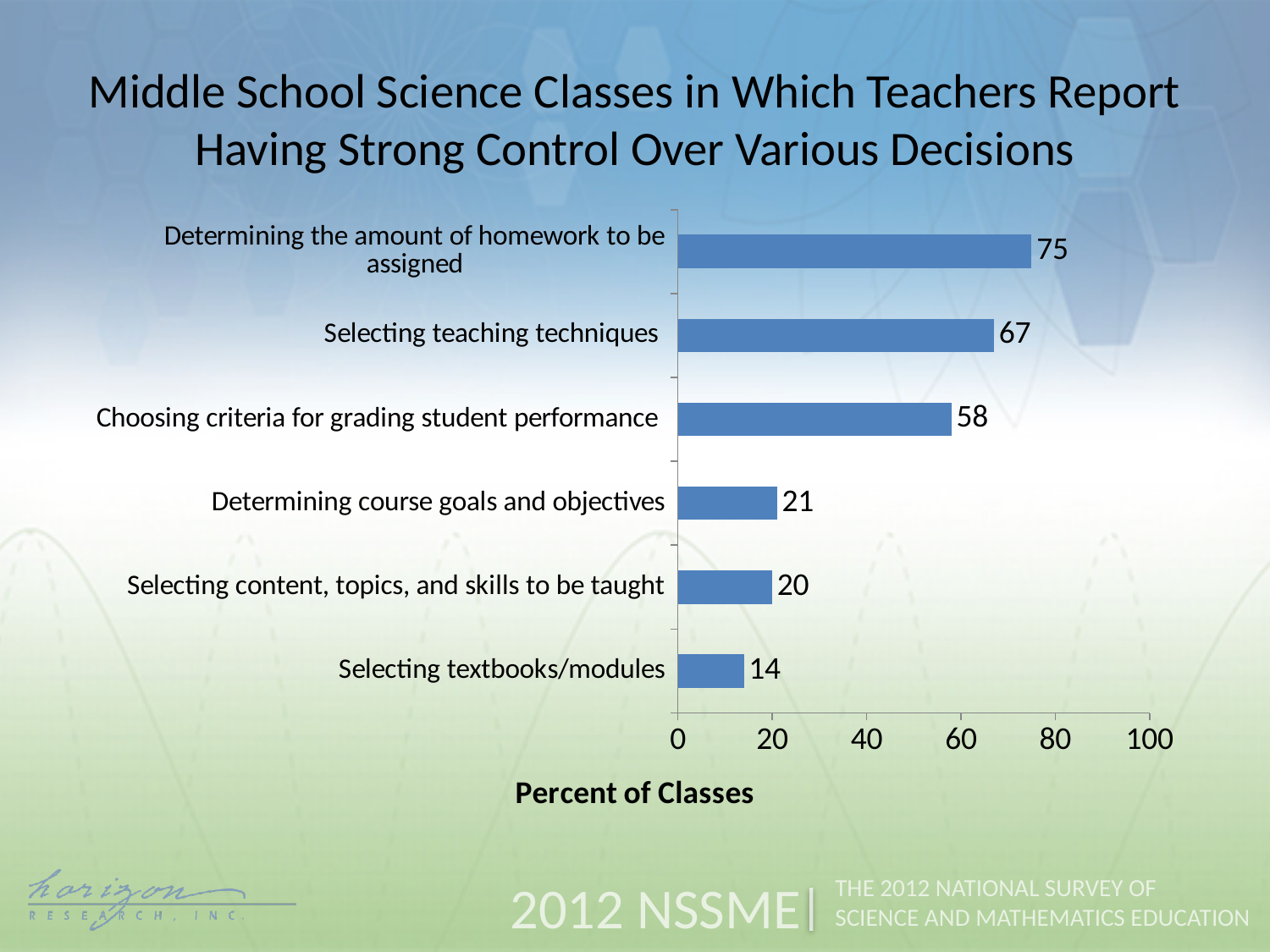
What is the value for "Selecting textbooks/modules"? 14 How many categories are shown in the chart? 6 Which category has the lowest value? Selecting textbooks/modules What is the difference between the values for "Determining the amount of homework to be assigned" and "Selecting teaching techniques"? 8 Is the value for "Choosing criteria for grading student performance" greater or less than 40? greater What is the label of the horizontal axis? Percent of Classes What percent of classes is shown for "Selecting teaching techniques"? 67 Which is larger: the value for "Determining course goals and objectives" or the value for "Selecting textbooks/modules"? Determining course goals and objectives What kind of chart is shown on the slide? Bar chart What is the difference between the values for "Choosing criteria for grading student performance" and "Selecting content, topics, and skills to be taught"? 38 Which category has the highest value? Determining the amount of homework to be assigned What is the value for "Choosing criteria for grading student performance"? 58